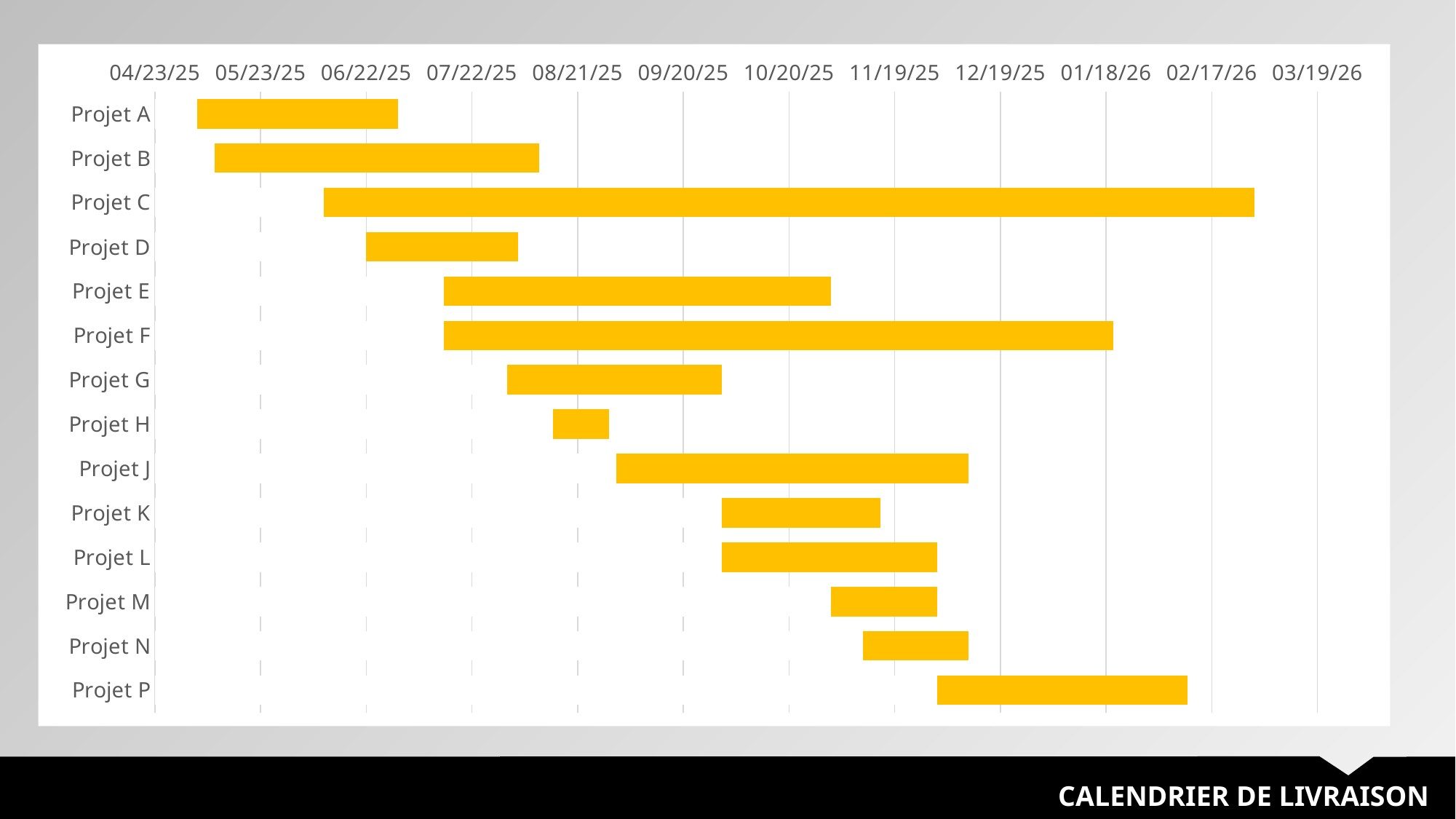
Does the bar for Projet C end before or after 02/17/26? after Which project's bar is longer, Projet A or Projet B? Projet B What kind of chart is shown on the slide? Bar chart (Gantt chart) Which project's bar is longer, Projet E or Projet F? Projet F Does the bar for Projet P end before or after 02/17/26? before Which project's bar starts latest on the timeline? Projet P What is the title shown on the slide? CALENDRIER DE LIVRAISON Going down the list of projects, do the bar start dates generally move later or earlier? later Which project has the shortest bar on the chart? Projet H How many projects are listed on the chart? 14 Does the bar for Projet A start before or after 05/23/25? before Which project has the longest bar on the chart? Projet C